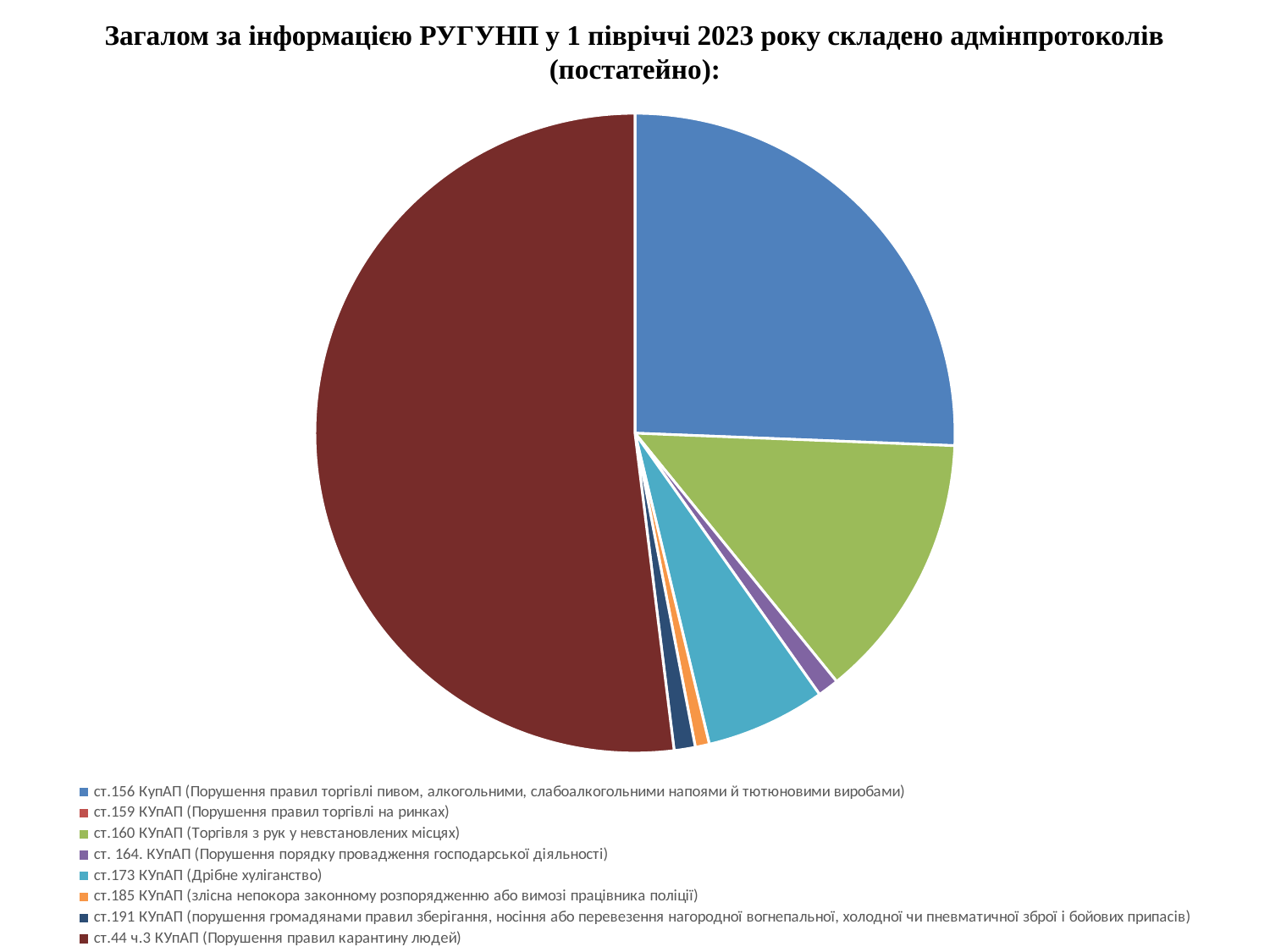
What colour is the slice for ст.44 ч.3 КУпАП (Порушення правил карантину людей)? dark red Which slice is larger: ст.156 КупАП or ст.160 КУпАП? ст.156 КупАП What kind of chart is shown on the slide? pie chart Which slice is larger: ст.185 КУпАП or ст.173 КУпАП? ст.173 КУпАП Which slice is larger: ст.44 ч.3 КУпАП or ст.156 КупАП? ст.44 ч.3 КУпАП Which category has the largest slice of the pie? ст.44 ч.3 КУпАП (Порушення правил карантину людей) Which category is the second-largest slice of the pie? ст.156 КупАП (Порушення правил торгівлі пивом, алкогольними, слабоалкогольними напоями й тютюновими виробами) How many entries does the legend list? 8 Which period does the chart title say the data covers? 1 півріччя 2023 року